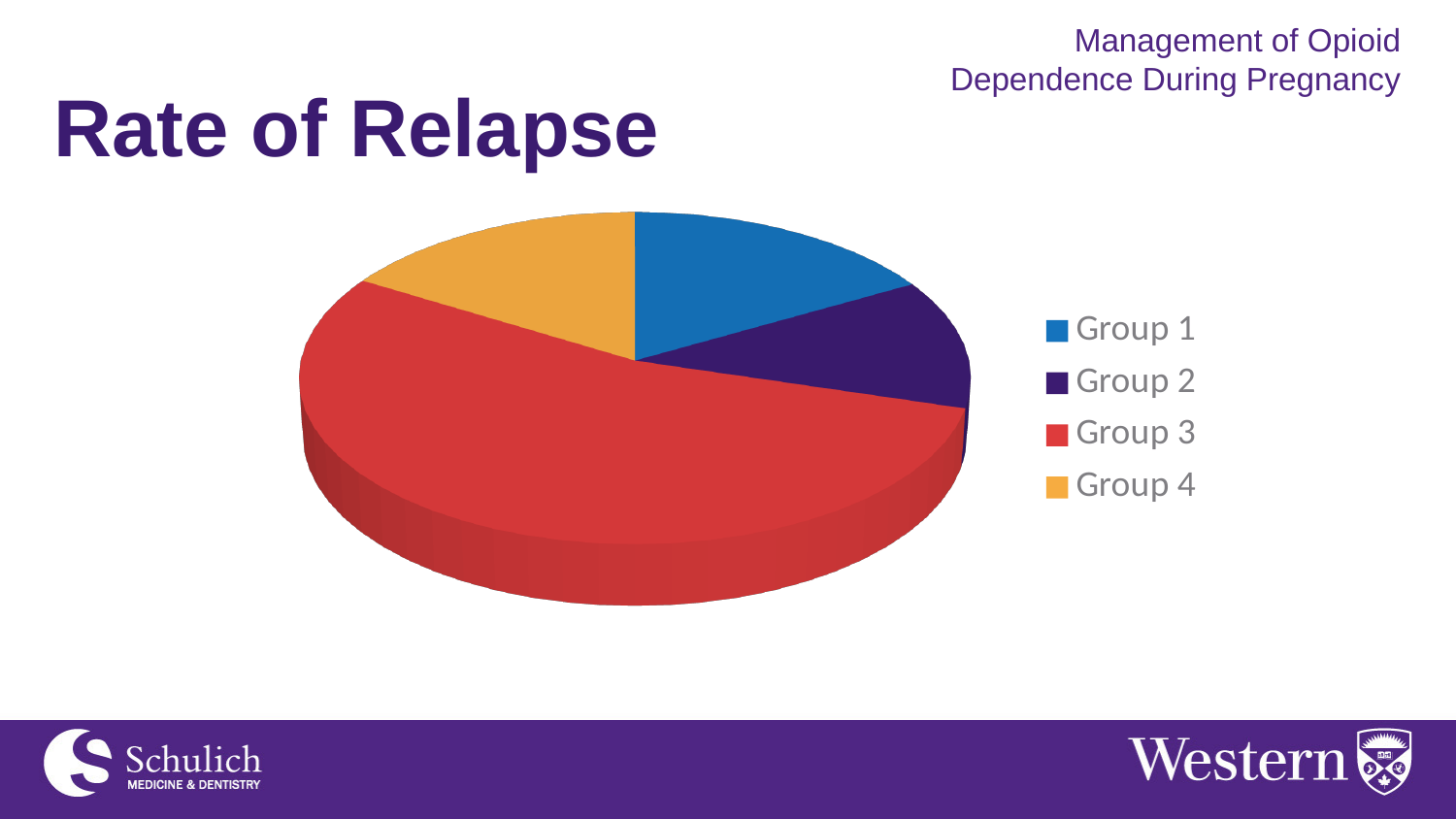
How many entries does the legend list? 4 Which group has the largest slice of the pie? Group 3 How many slices does the pie chart have? 4 Which group has the smallest slice of the pie? Group 2 What colour is the slice for Group 3 in the pie chart? Red Which slice is larger, Group 3 or Group 1? Group 3 What is the title of the chart on the slide? Rate of Relapse What kind of chart is shown on the slide? Pie chart Does Group 3 account for more or less than half of the pie? More Which slice is larger, Group 4 or Group 2? Group 4